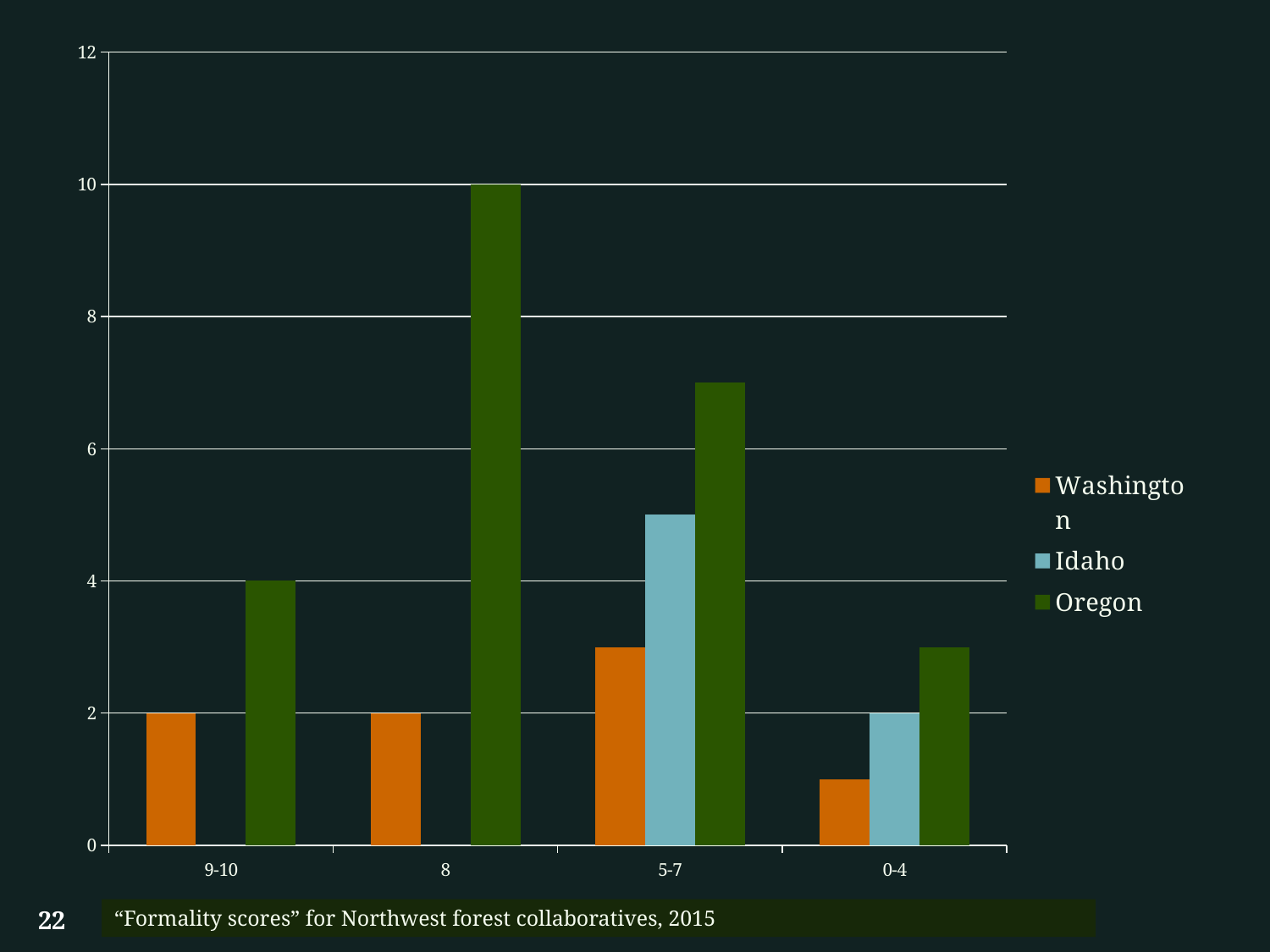
How many series does the legend list? 3 What is the value for Oregon in the 9-10 category? 4 Which category has the lowest Washington bar? 0-4 Is the value for Oregon in the 5-7 category greater or less than 6? greater What is the difference between the Oregon and Washington values in the 8 category? 8 What is the value for Washington in the 9-10 category? 2 What is the value for Oregon in the 8 category? 10 What kind of chart is shown on the slide? bar chart How many categories are shown on the x axis? 4 Which category has the highest Oregon bar? 8 In the 5-7 category, which is larger, Oregon or Idaho? Oregon What is the value for Idaho in the 0-4 category? 2